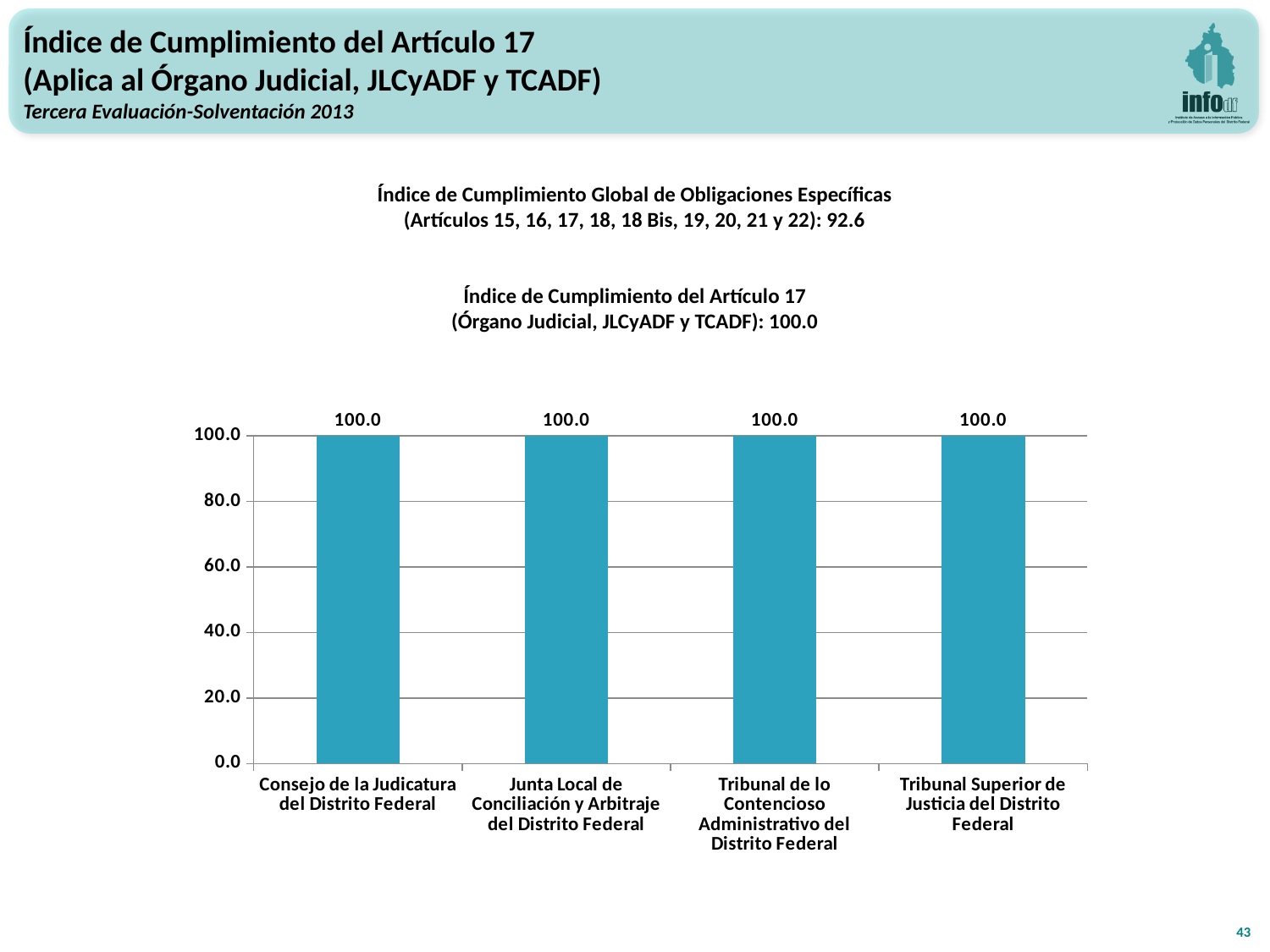
What is the value for Tribunal Superior de Justicia del Distrito Federal? 100.0 What is the highest value shown on the vertical axis? 100.0 What is the difference between the values for Consejo de la Judicatura del Distrito Federal and Tribunal Superior de Justicia del Distrito Federal? 0.0 How many categories are shown in the chart? 4 Is the value for Junta Local de Conciliación y Arbitraje del Distrito Federal greater or less than 80.0? greater What kind of chart is shown on the slide? Bar chart What is the value for Junta Local de Conciliación y Arbitraje del Distrito Federal? 100.0 What is the Índice de Cumplimiento del Artículo 17 (Órgano Judicial, JLCyADF y TCADF) stated on the slide? 100.0 Do the values rise, fall, or stay the same across the categories from left to right? Stay the same What is the value for Consejo de la Judicatura del Distrito Federal? 100.0 What is the value for Tribunal de lo Contencioso Administrativo del Distrito Federal? 100.0